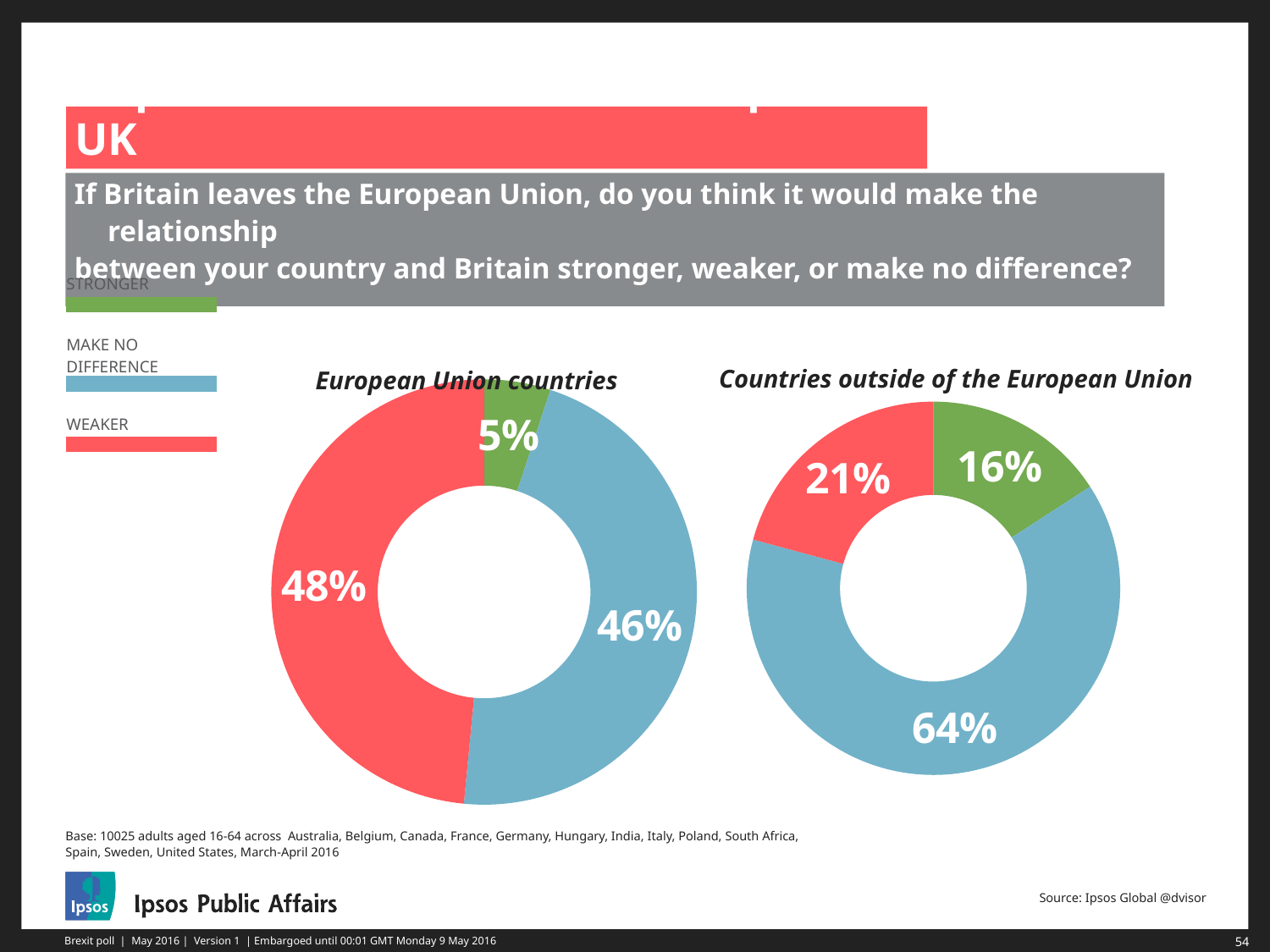
Is the 'Stronger' share larger in the 'European Union countries' chart or in the 'Countries outside of the European Union' chart? Countries outside of the European Union What type of chart is used on this slide? Donut (pie) chart In the 'European Union countries' chart, what percentage say the relationship would be weaker? 48% In the 'Countries outside of the European Union' chart, what percentage say the relationship would be stronger? 16% How many response categories does the legend list? 3 In the 'European Union countries' chart, what percentage say the relationship would be stronger? 5% In the 'Countries outside of the European Union' chart, what percentage say it would make no difference? 64% In the 'European Union countries' chart, which response has the smallest share? Stronger In the 'Countries outside of the European Union' chart, which response has the largest share? Make no difference In the 'European Union countries' chart, what percentage say it would make no difference? 46% What is the difference between the 'Weaker' share in the 'European Union countries' chart and the 'Weaker' share in the 'Countries outside of the European Union' chart? 27 percentage points In the 'Countries outside of the European Union' chart, what percentage say the relationship would be weaker? 21%